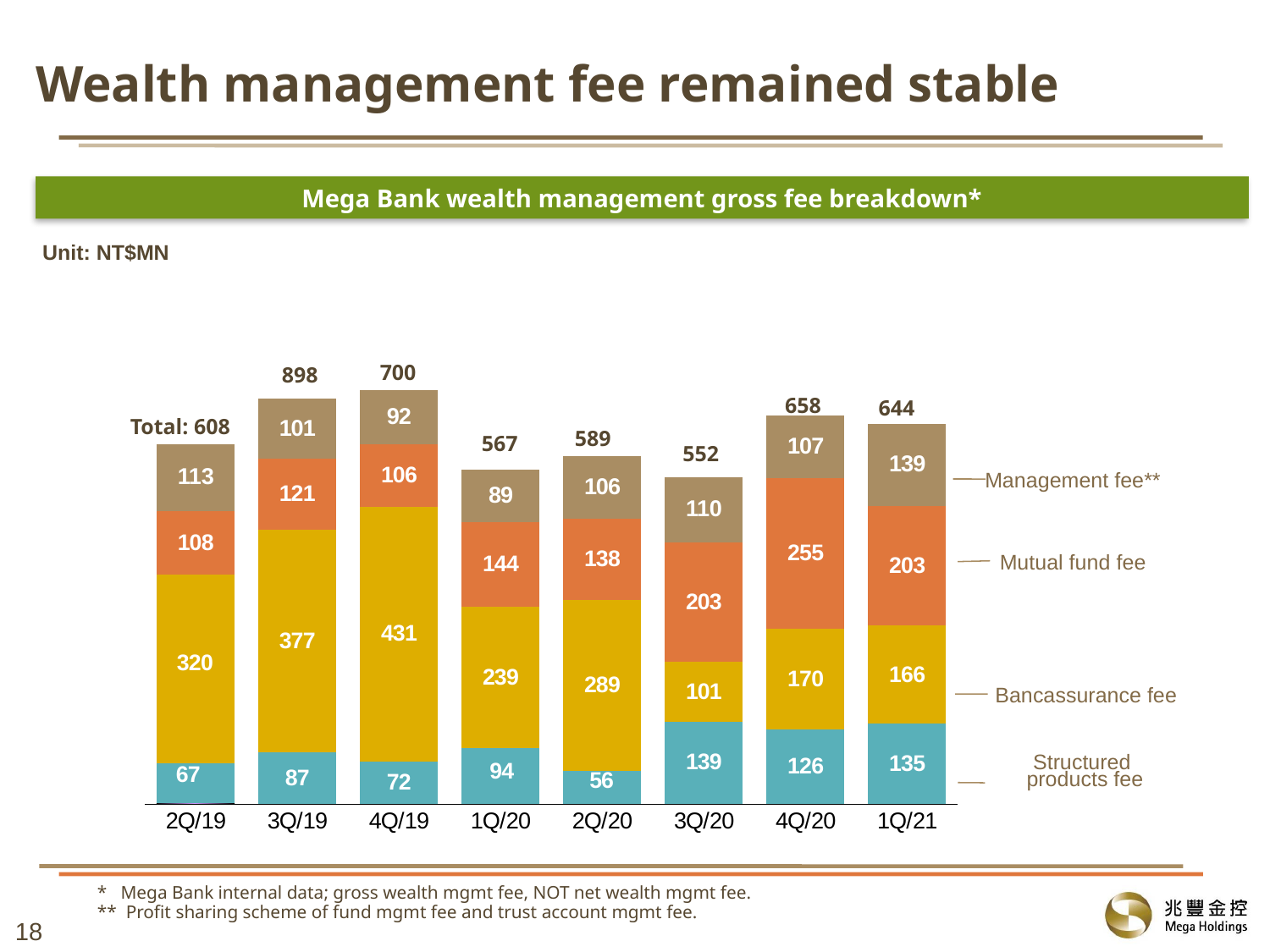
How many quarters are shown on the x axis of the chart? 8 What unit are the values in the chart expressed in? NT$MN Which quarter has the larger Management fee, 4Q/20 or 1Q/21? 1Q/21 What is the Bancassurance fee in 4Q/19? 431 What is the total wealth management gross fee in 1Q/21? 644 What is the difference between the Mutual fund fee in 4Q/20 and in 1Q/21? 52 What is the Mutual fund fee in 3Q/20? 203 Which quarter has the highest total wealth management gross fee? 3Q/19 What kind of chart is shown on the slide? Stacked bar chart What is the Structured products fee in 2Q/20? 56 Which quarter has the lowest Structured products fee? 2Q/20 How many fee categories (series) does the chart legend list? 4